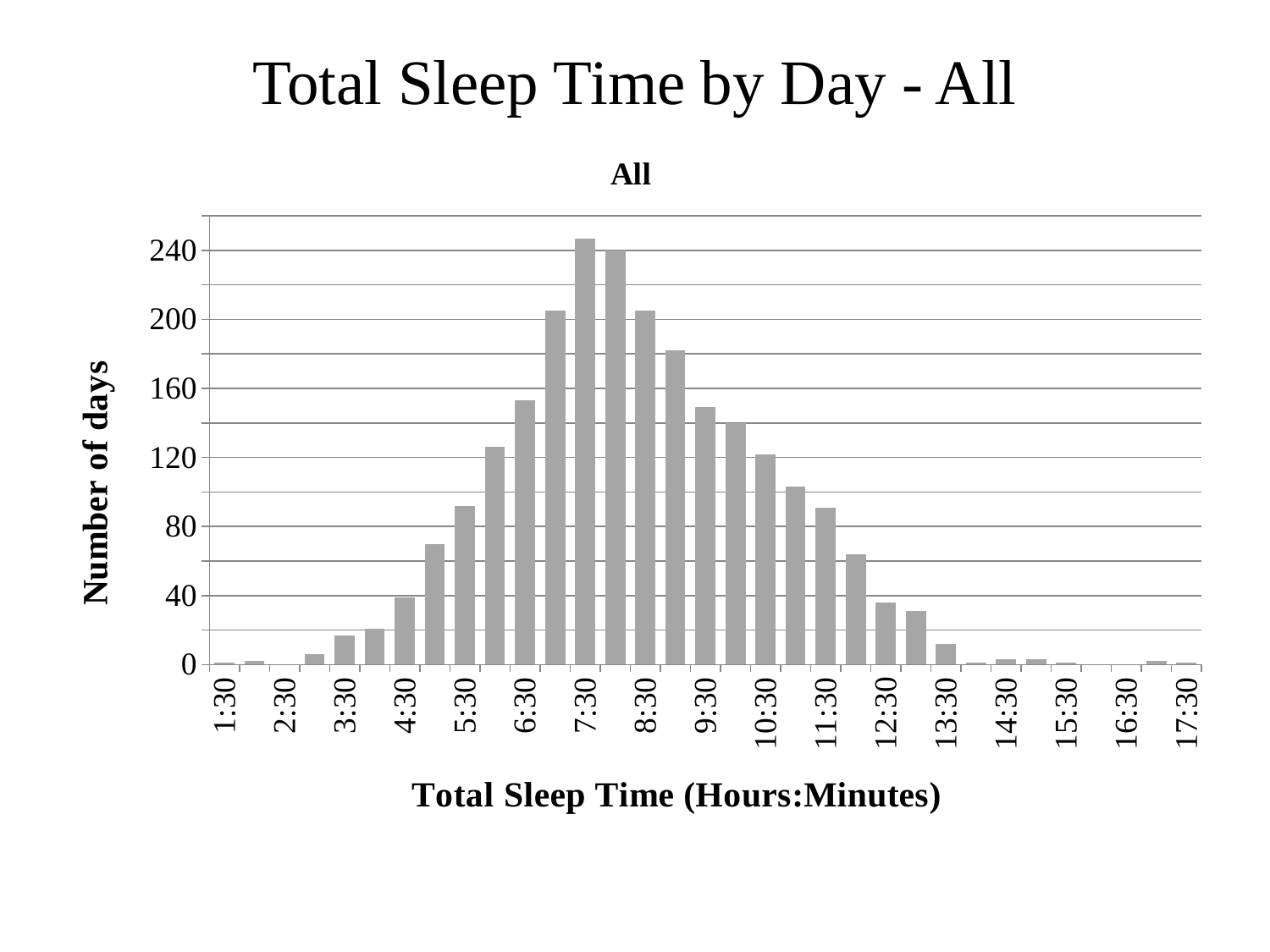
Is the number of days for 6:30 greater or less than 160? less Is the number of days for 9:30 greater or less than 160? less Do the values rise or fall along the x axis from 8:30 to 13:30? fall Is the number of days for 7:30 greater or less than 240? greater Which has more days, 8:30 or 9:30? 8:30 Which total sleep time has the highest number of days? 7:30 What is the title of the x axis? Total Sleep Time (Hours:Minutes) Which has more days, 6:30 or 10:30? 6:30 What kind of chart is shown on the slide? bar chart